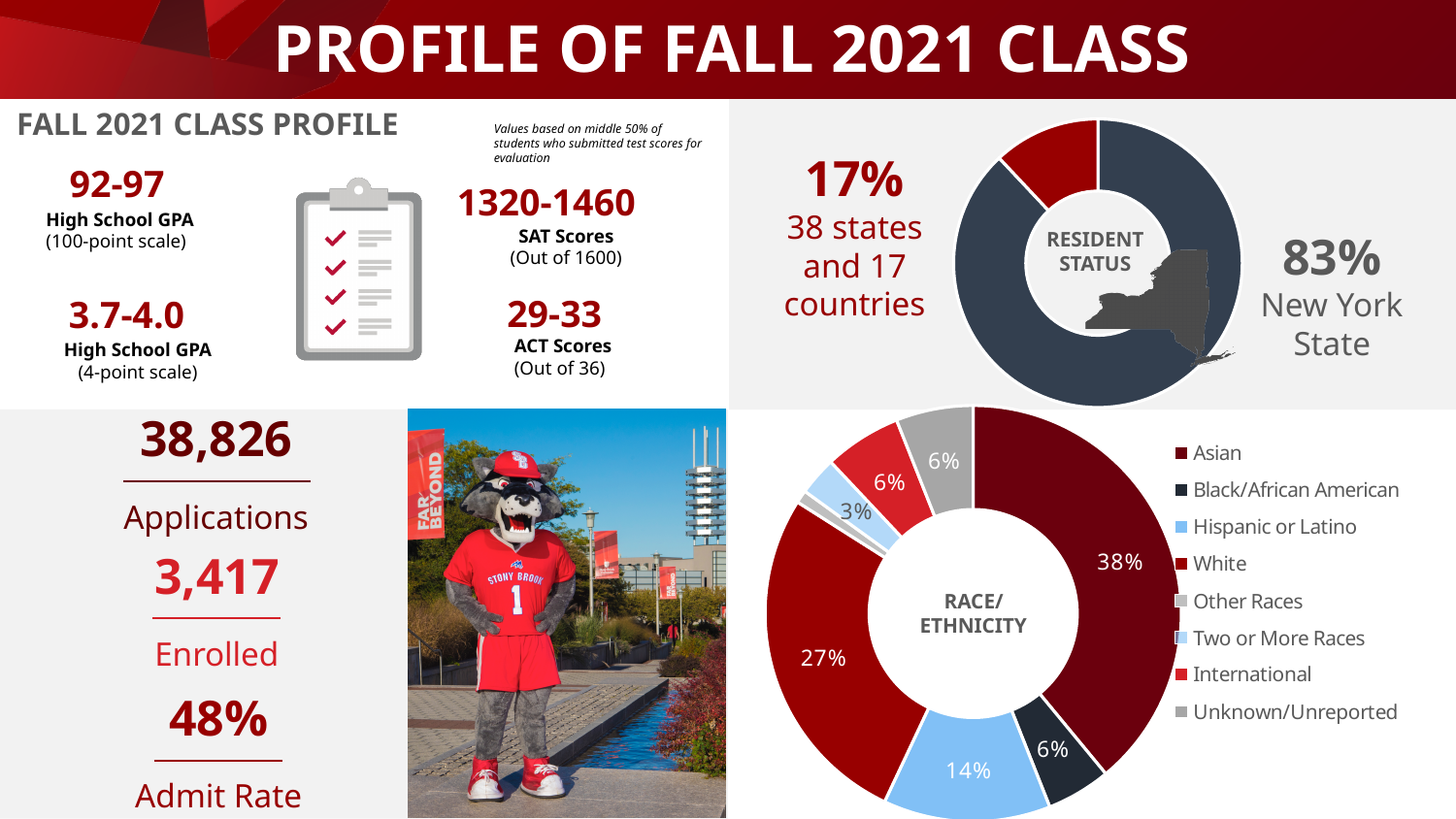
On the Race/Ethnicity chart, what percentage is labelled for Black/African American? 6% On the Race/Ethnicity chart, what percentage is labelled for Hispanic or Latino? 14% On the Race/Ethnicity chart, how many entries does the legend list? 8 On the Race/Ethnicity chart, what is the difference between the 38% slice and the 27% slice? 11% On the Resident Status chart, what percentage of the class comes from the 38 states and 17 countries outside New York? 17% What kind of chart is the Resident Status chart? Donut (pie) chart On the Race/Ethnicity chart, what is the largest percentage shown? 38% On the Race/Ethnicity chart, what is the smallest percentage shown? 3% On the Resident Status chart, what percentage of the class is from New York State? 83% What kind of chart is the Race/Ethnicity chart? Donut (pie) chart On the Resident Status chart, what is the difference between the New York State share and the share from other states and countries? 66% On the Resident Status chart, which is larger: the New York State share or the share from other states and countries? New York State